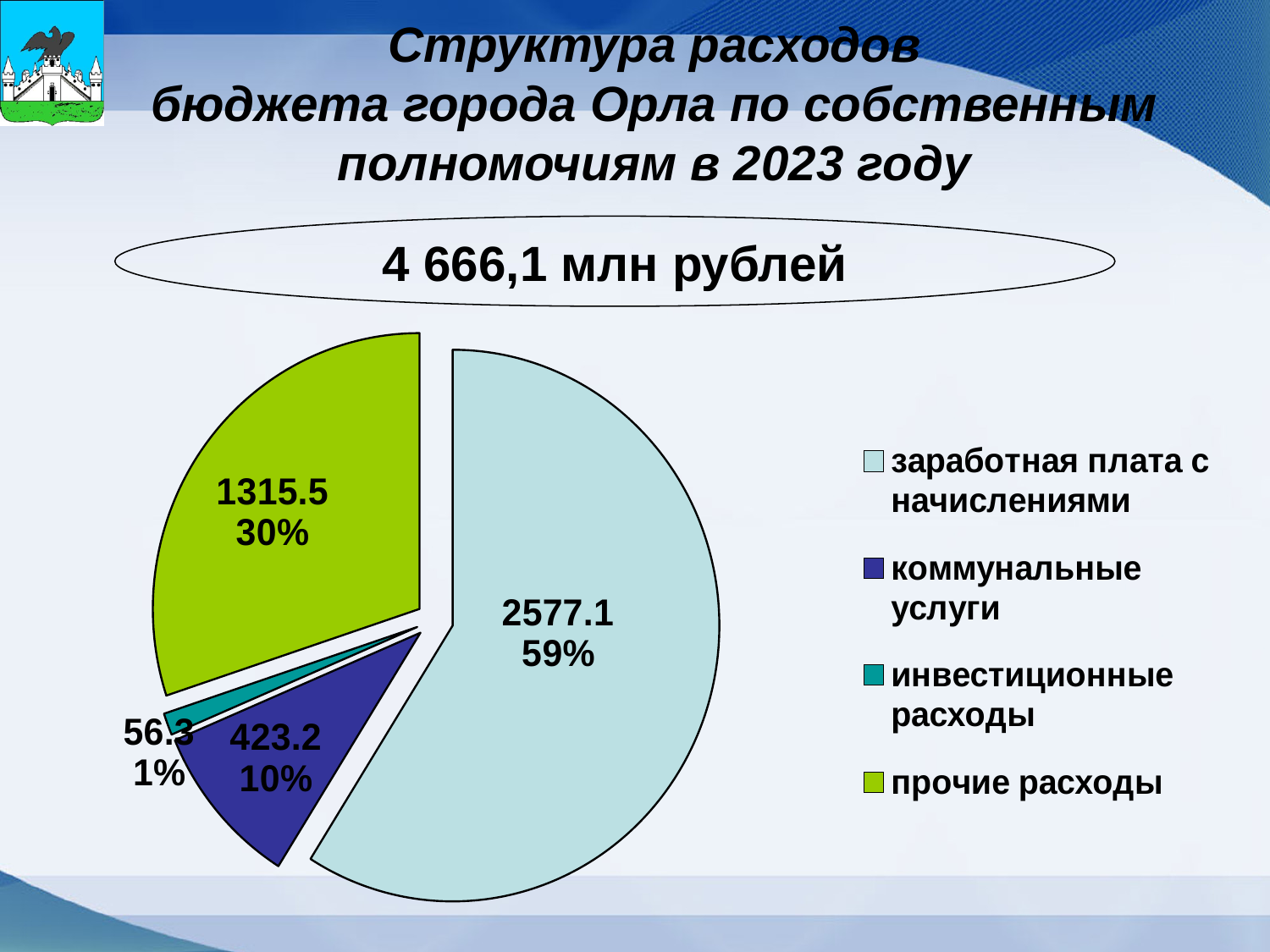
How many slices does the pie chart have? 4 What share of the pie does "заработная плата с начислениями" take? 59% What type of chart is shown on the slide? pie chart Which category has the smallest slice of the pie? инвестиционные расходы What share of the pie does "инвестиционные расходы" take? 1% What is the value shown for "коммунальные услуги"? 423.2 Which category has the largest slice of the pie? заработная плата с начислениями How many entries does the legend list? 4 What is the value shown for "заработная плата с начислениями"? 2577.1 What is the difference between the values for "заработная плата с начислениями" and "прочие расходы"? 1261.6 What is the value shown for "прочие расходы"? 1315.5 What share of the pie does "прочие расходы" take? 30%